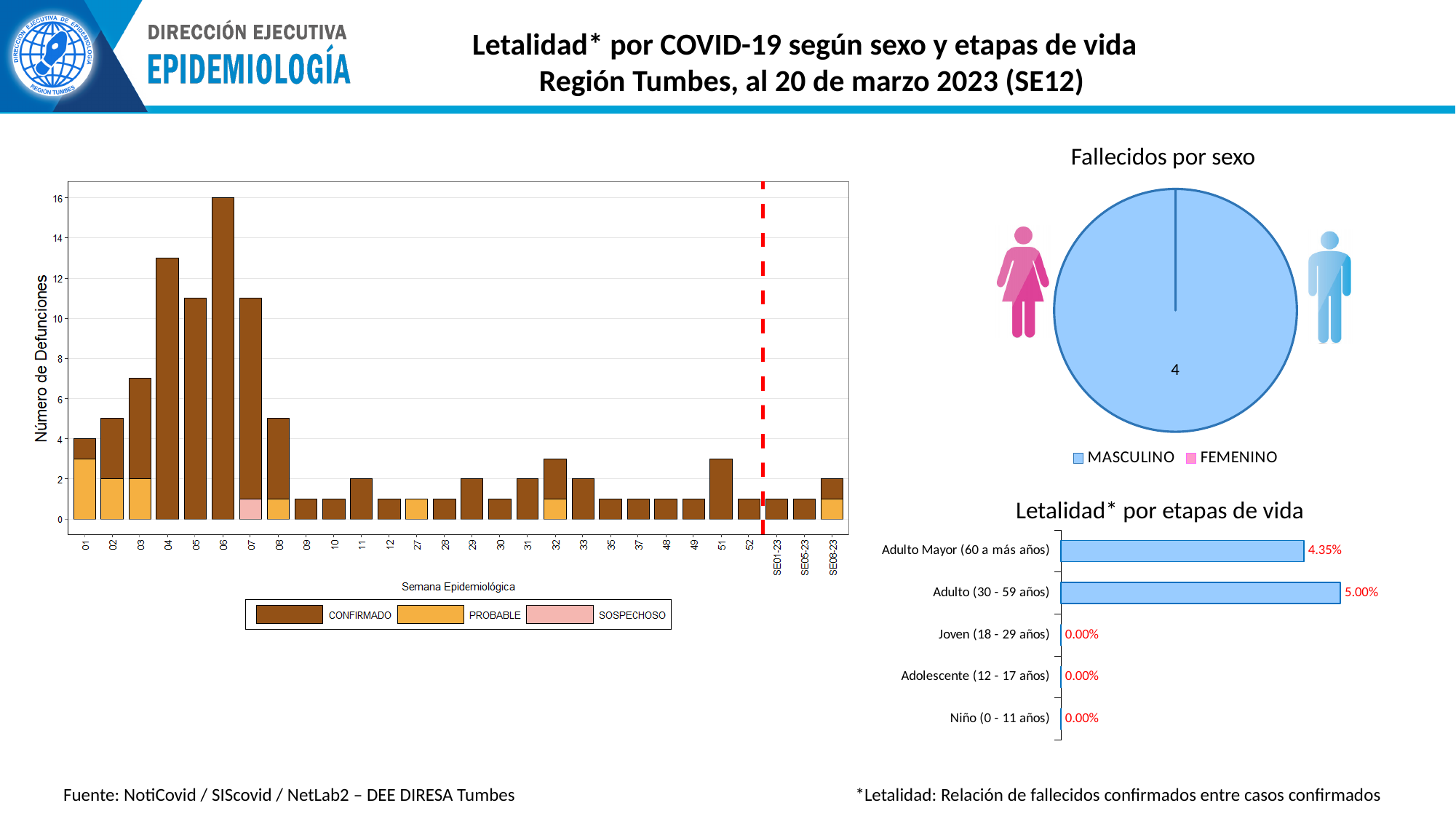
What kind of chart is 'Fallecidos por sexo'? Pie chart In the 'Letalidad* por etapas de vida' chart, what is the value for Joven (18 - 29 años)? 0.00% In the 'Letalidad* por etapas de vida' chart, what is the value for Adulto Mayor (60 a más años)? 4.35% In the left chart of deaths by epidemiological week, which week has the highest number of deaths? 06 How many age groups are shown in the 'Letalidad* por etapas de vida' chart? 5 How many series does the legend of the left chart of deaths by epidemiological week list? 3 In the left chart of deaths by epidemiological week, is the total for week 04 greater or less than 12? greater In the 'Letalidad* por etapas de vida' chart, what is the value for Adulto (30 - 59 años)? 5.00% In the 'Fallecidos por sexo' pie chart, what value is printed on the MASCULINO slice? 4 How many entries does the legend of the 'Fallecidos por sexo' chart list? 2 In the 'Letalidad* por etapas de vida' chart, what is the difference between the values for Adulto (30 - 59 años) and Adulto Mayor (60 a más años)? 0.65% In the 'Letalidad* por etapas de vida' chart, which age group has the highest value? Adulto (30 - 59 años)